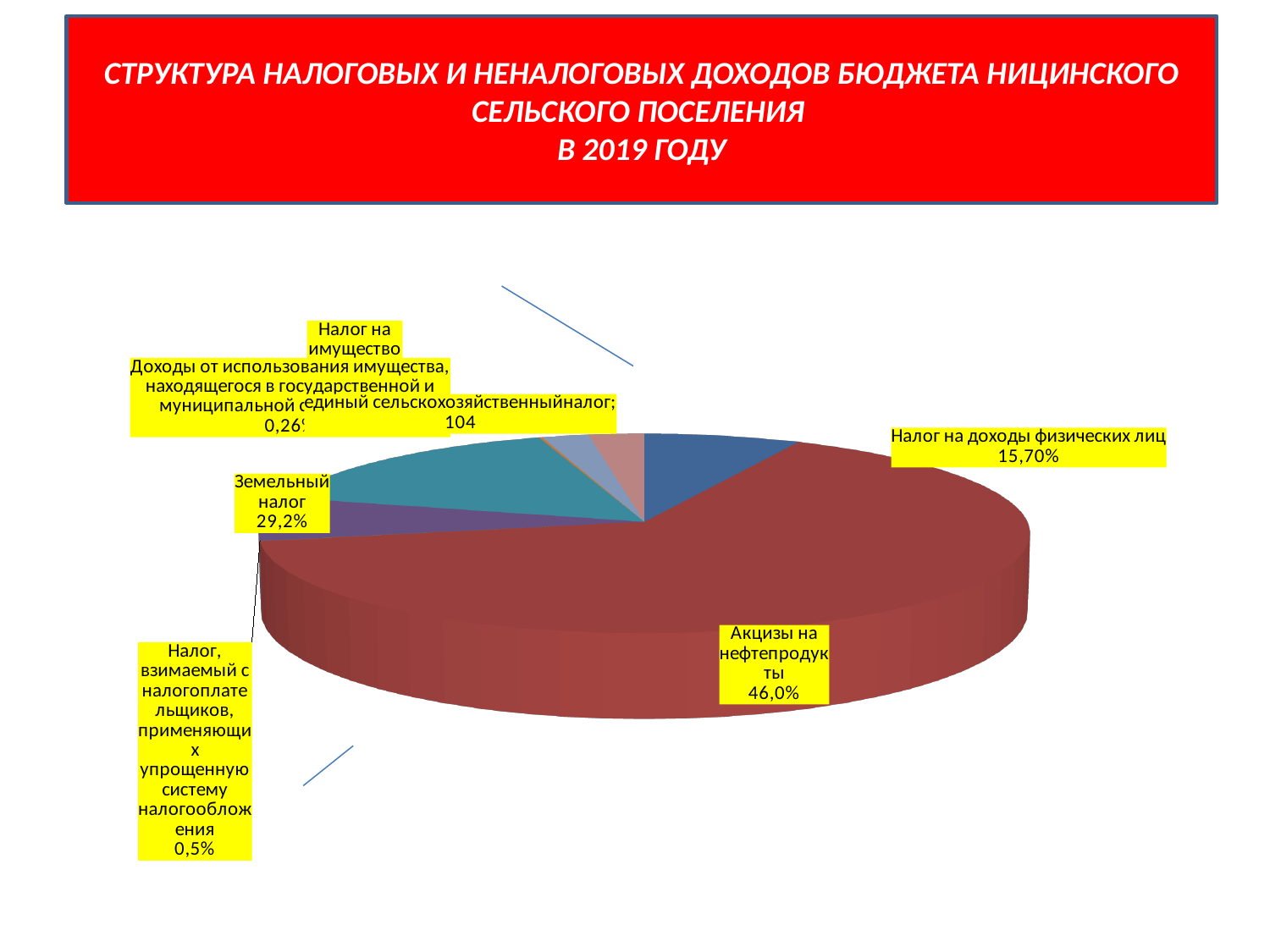
Which is larger: the share for "Земельный налог" or the share for "Налог на доходы физических лиц"? Земельный налог What share of the pie does "Налог, взимаемый с налогоплательщиков, применяющих упрощенную систему налогообложения" have? 0,5% By how many percentage points does the share of "Акцизы на нефтепродукты" exceed the share of "Земельный налог"? 16,8 Which category has the largest slice of the pie? Акцизы на нефтепродукты What colour is the slice for "Акцизы на нефтепродукты"? red By how many percentage points does the share of "Земельный налог" exceed the share of "Налог на доходы физических лиц"? 13,5 What kind of chart is shown on the slide? pie chart Which year does the chart title say the budget revenue structure refers to? 2019 What share of the pie does "Налог на доходы физических лиц" have? 15,70% What share of the pie does "Акцизы на нефтепродукты" have? 46,0% What share of the pie does "Земельный налог" have? 29,2% By how many percentage points does the share of "Акцизы на нефтепродукты" exceed the share of "Налог на доходы физических лиц"? 30,3